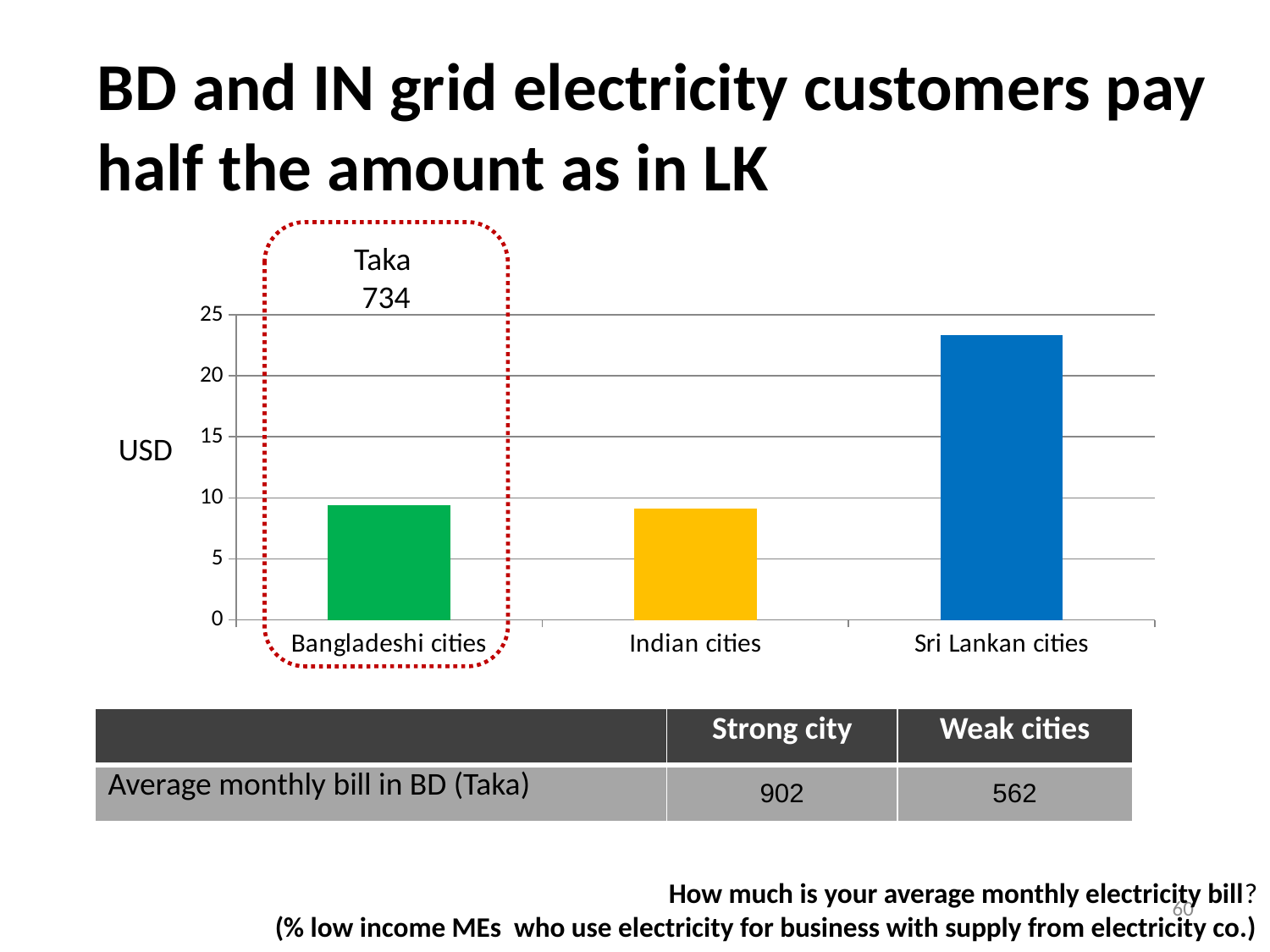
Which is larger, the value for Sri Lankan cities or the value for Indian cities? Sri Lankan cities Is the value for Indian cities greater or less than 10? less What kind of chart is shown on the slide? bar chart What unit is shown on the vertical axis of the chart? USD Is the value for Indian cities greater or less than 5? greater Which category on the chart is enclosed by the red dotted outline? Bangladeshi cities Is the value for Sri Lankan cities greater or less than 20? greater Which is larger, the value for Bangladeshi cities or the value for Sri Lankan cities? Sri Lankan cities How many categories (city groups) are plotted on the chart? 3 Which category has the highest bar on the chart? Sri Lankan cities